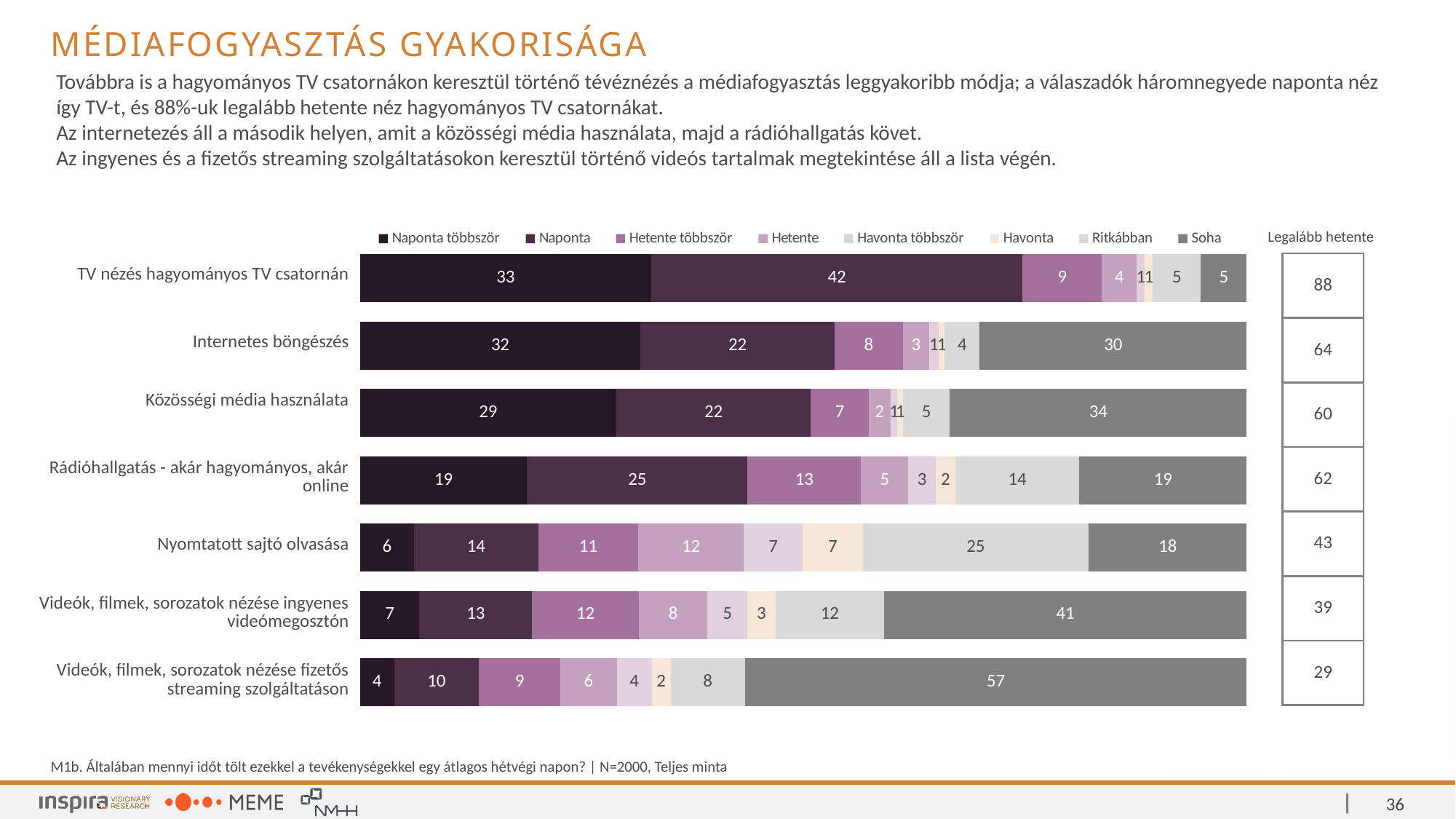
Which category has the lowest value for "Naponta többször"? Videók, filmek, sorozatok nézése fizetős streaming szolgáltatáson What is the difference between the "Naponta" value for "TV nézés hagyományos TV csatornán" and the "Naponta" value for "Internetes böngészés"? 20 What kind of chart is shown on the slide? Stacked bar chart What is the value for "Soha" for "Videók, filmek, sorozatok nézése fizetős streaming szolgáltatáson"? 57 What is the "Legalább hetente" value for "Rádióhallgatás - akár hagyományos, akár online"? 62 Which has a larger "Soha" value: "Internetes böngészés" or "Közösségi média használata"? Közösségi média használata How many series does the legend list? 8 What is the heading of the column of values to the right of the chart? Legalább hetente How many categories (activities) are shown in the chart? 7 What is the value for "Ritkábban" for "Nyomtatott sajtó olvasása"? 25 Which category has the highest value for "Soha"? Videók, filmek, sorozatok nézése fizetős streaming szolgáltatáson What is the value for "Naponta többször" for "TV nézés hagyományos TV csatornán"? 33